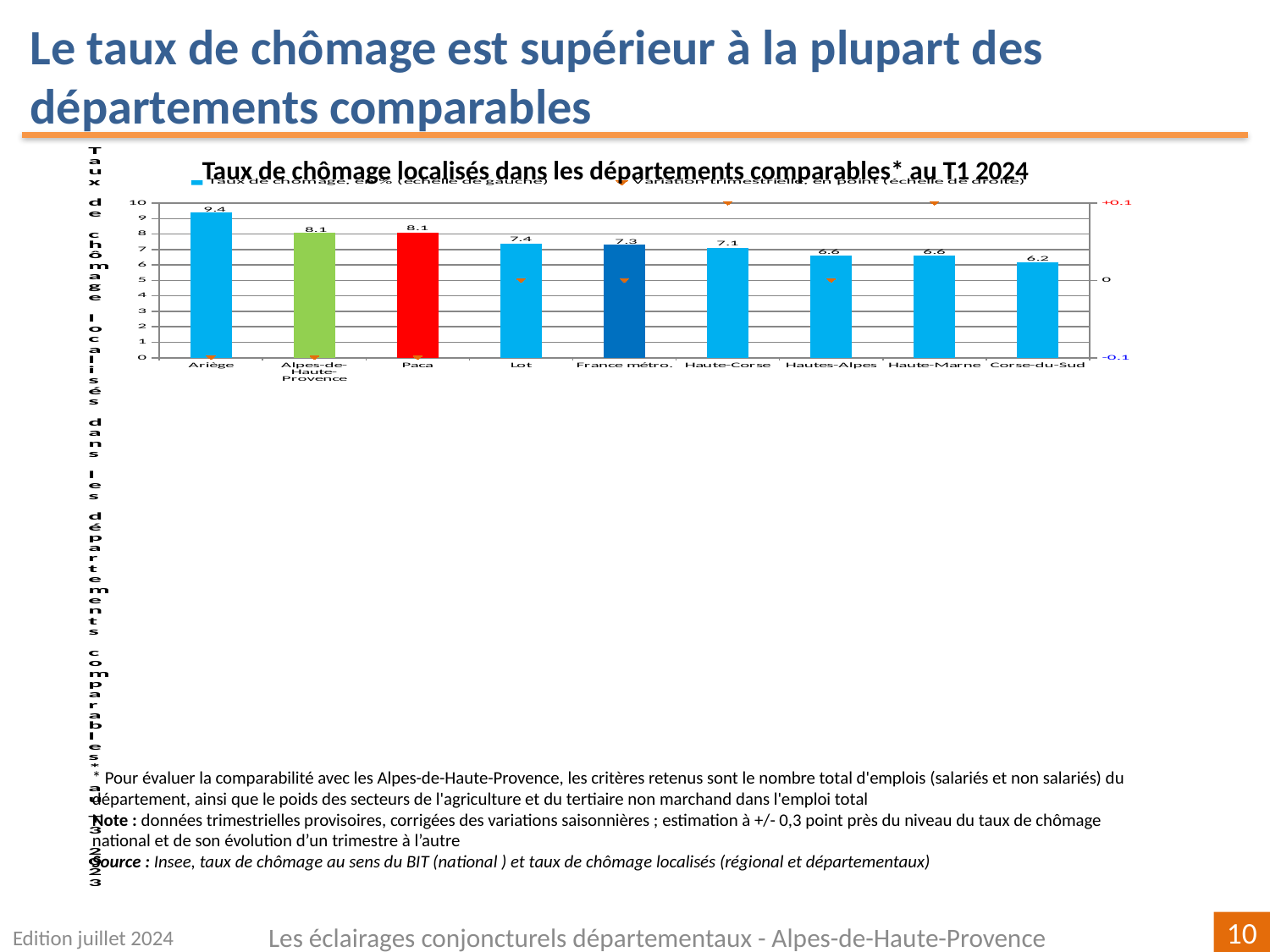
Do the unemployment rate bars rise or fall from left to right along the x axis? fall Which category has the highest unemployment rate? Ariège How many series does the legend list? 2 What is the difference between the unemployment rates of Ariège and Corse-du-Sud? 3.2 Is the value for Hautes-Alpes greater or less than 7? less How many categories are shown on the x axis? 9 What is the unemployment rate shown for France métro.? 7.3 What is the unemployment rate shown for Alpes-de-Haute-Provence? 8.1 What is the unemployment rate shown for Ariège? 9.4 Which has a higher unemployment rate, Lot or Haute-Corse? Lot What kind of chart is used to show the unemployment rates? bar chart Which category has the lowest unemployment rate? Corse-du-Sud